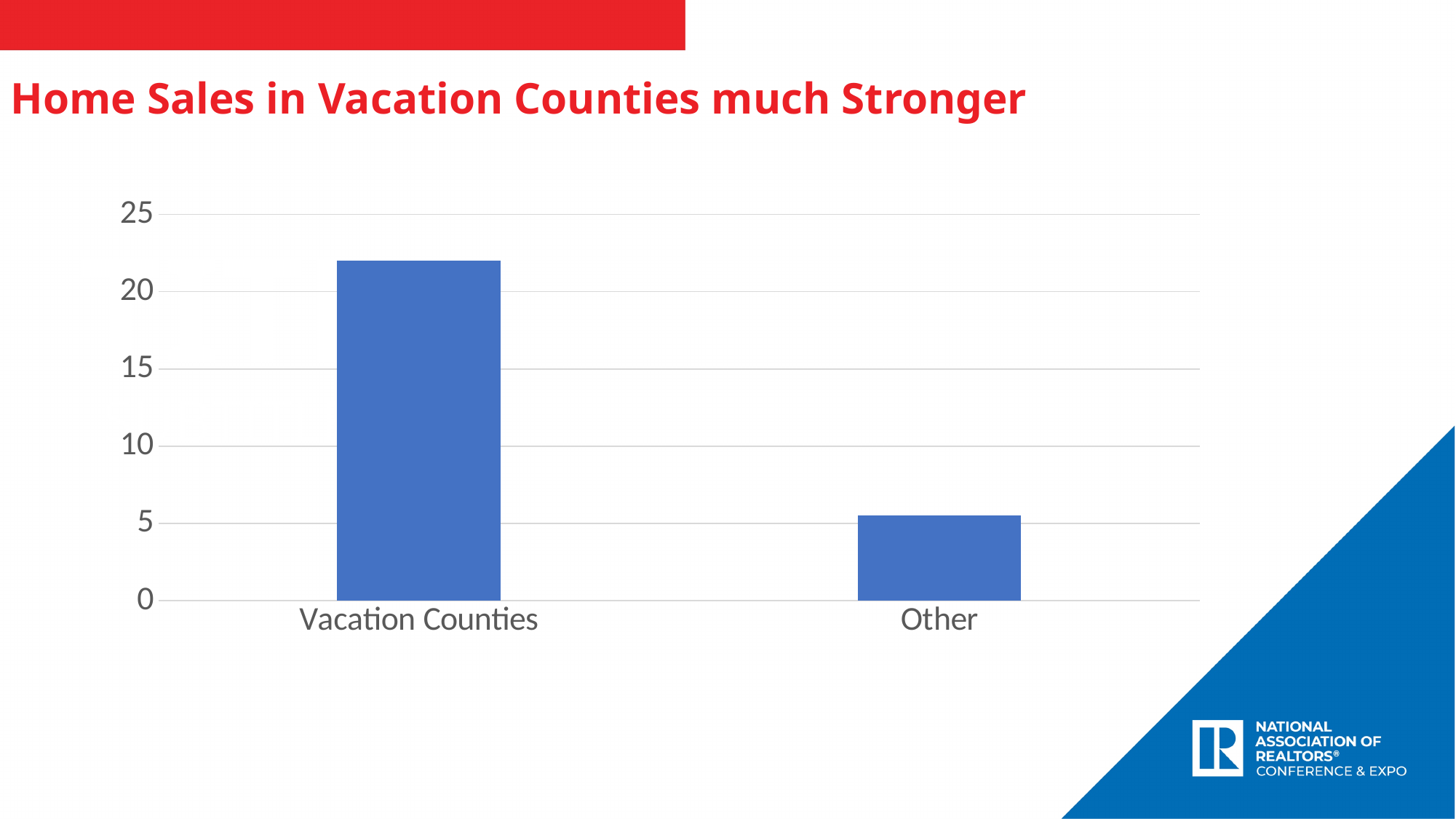
What is the title of the slide containing the chart? Home Sales in Vacation Counties much Stronger Is the value for Other greater or less than 10? less Is the value for Vacation Counties greater or less than 25? less What kind of chart is shown on the slide? bar chart How many categories are plotted in the chart? 2 Which category has the lowest value? Other Which category has the highest value? Vacation Counties Which is larger, the value for Vacation Counties or the value for Other? Vacation Counties Is the value for Vacation Counties greater or less than 20? greater What is the highest value shown on the vertical axis? 25 Do the values rise or fall from left to right across the categories? fall